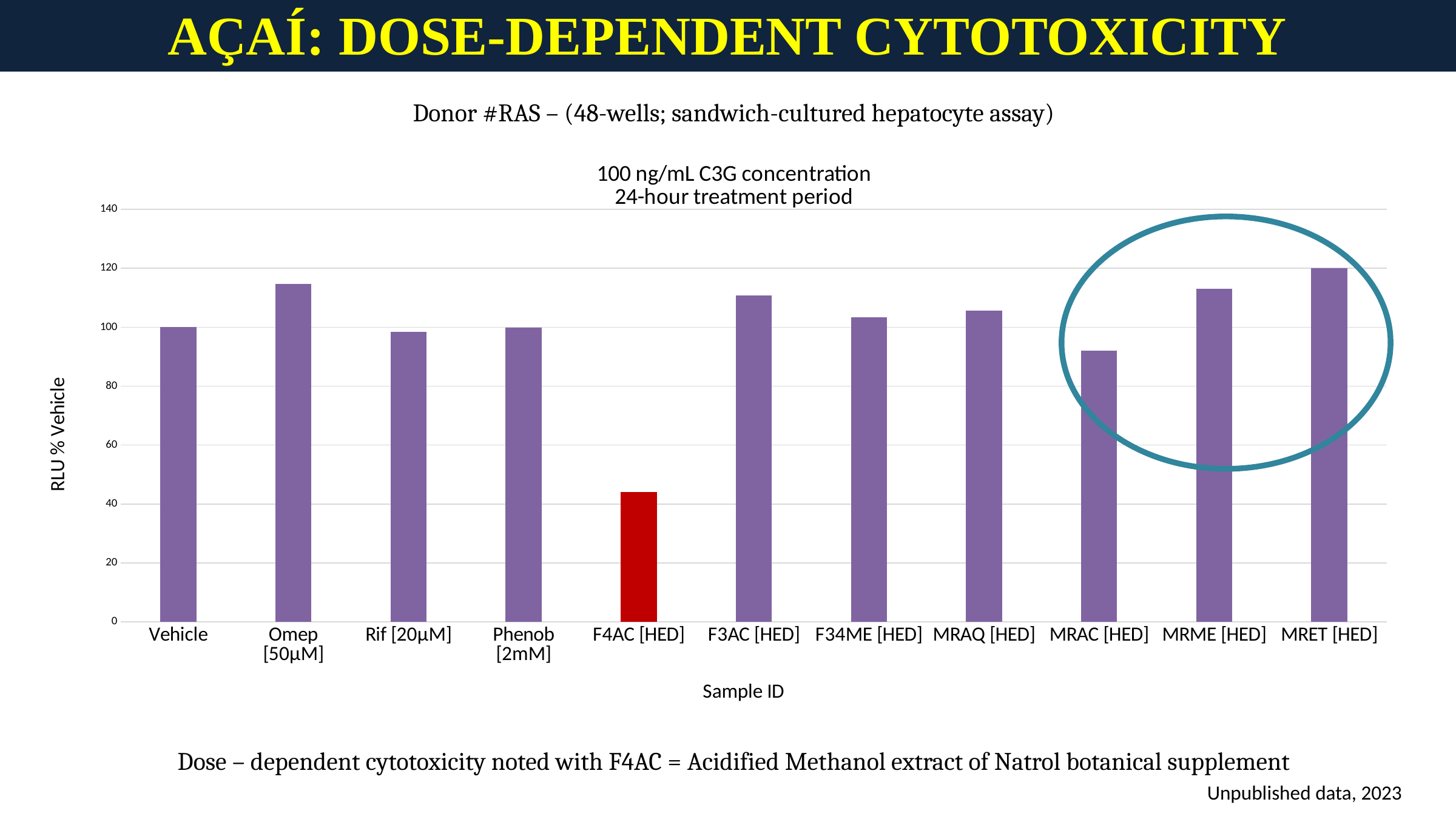
Which bar is coloured red rather than purple? F4AC [HED] Is the value for Omep [50µM] greater or less than 100? greater What is the RLU % Vehicle value for Vehicle? 100 How many sample IDs are plotted on the x axis? 11 What is the label of the y axis? RLU % Vehicle Which is larger, the value for F4AC [HED] or the value for F3AC [HED]? F3AC [HED] Which is larger, the value for MRAC [HED] or the value for MRME [HED]? MRME [HED] Which sample has the lowest RLU % Vehicle value? F4AC [HED] What kind of chart is shown on the slide? Bar chart Which sample has the highest RLU % Vehicle value? MRET [HED] Is the value for F4AC [HED] greater or less than 60? less Is the value for MRAC [HED] greater or less than 100? less